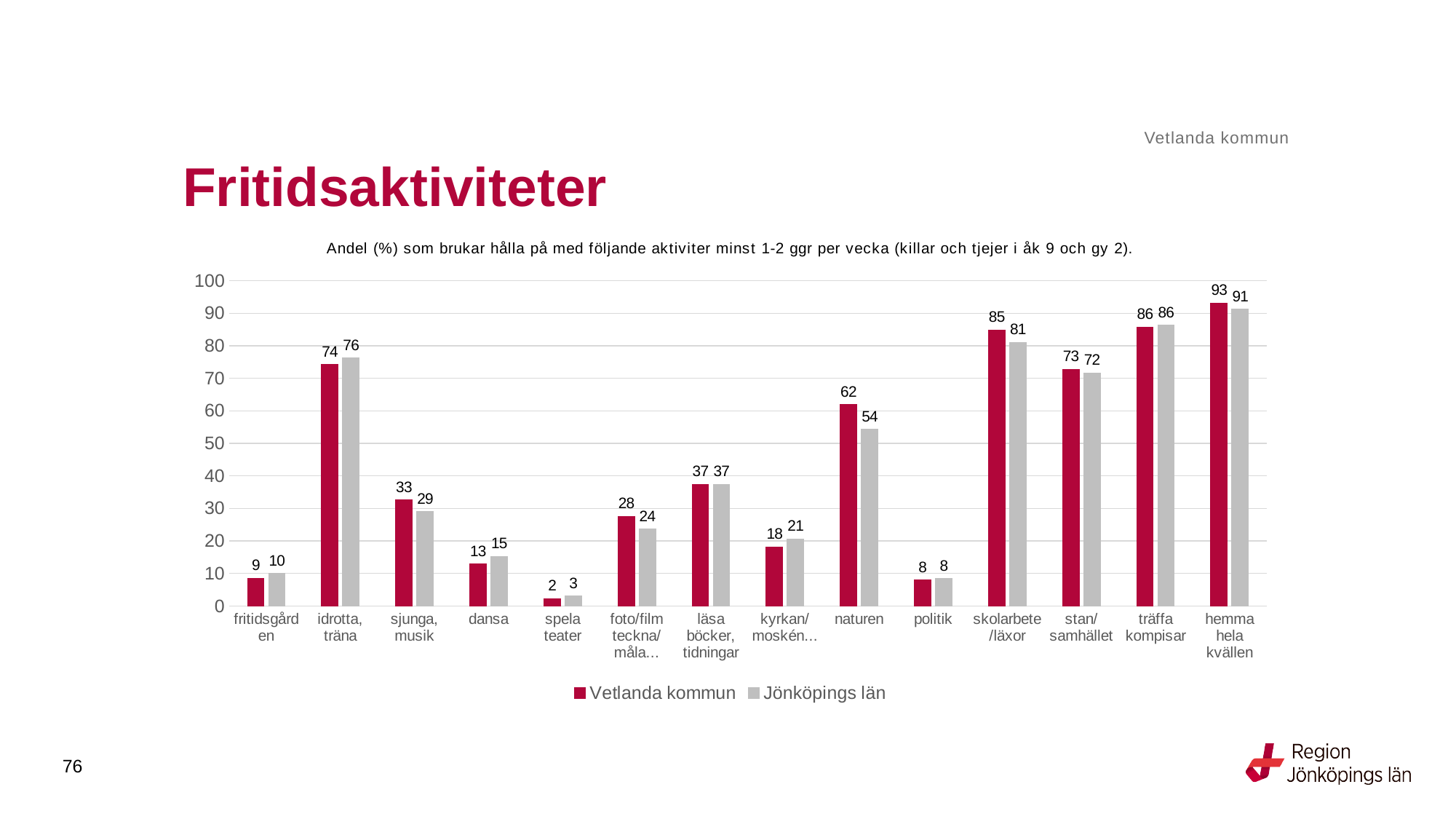
What is the difference between Vetlanda kommun and Jönköpings län for 'skolarbete/läxor'? 4 Which is larger for 'sjunga, musik': Vetlanda kommun or Jönköpings län? Vetlanda kommun Which category has the lowest value for Jönköpings län? spela teater What colour are the bars for Vetlanda kommun? red What kind of chart is shown on the slide? bar chart What is the value for Vetlanda kommun for 'naturen'? 62 What is the value for Vetlanda kommun for 'politik'? 8 Which category has the highest value for Vetlanda kommun? hemma hela kvällen How many series does the legend list? 2 What is the difference between Vetlanda kommun and Jönköpings län for 'naturen'? 8 What is the value for Jönköpings län for 'idrotta, träna'? 76 How many categories are shown on the x axis? 14